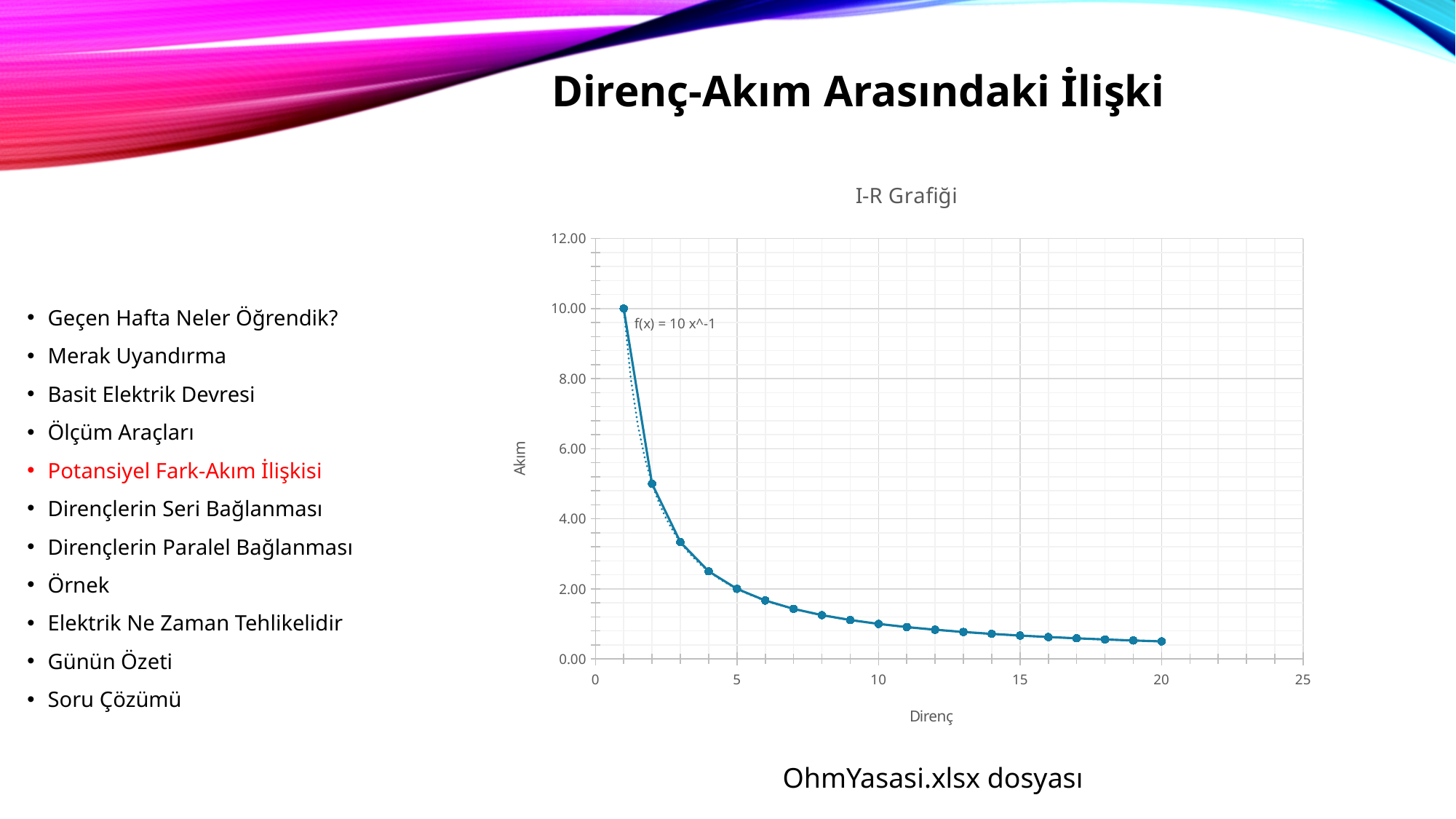
At which Direnç value is Akım lowest? 20 Is the Akım value at Direnç = 2 greater or less than 4.00? greater What kind of chart is shown on the slide? line chart What is the Akım value at Direnç = 1? 10.00 How many data points are plotted on the chart? 20 Which has the larger Akım value, Direnç = 3 or Direnç = 15? Direnç = 3 What is the title of the chart? I-R Grafiği What is the label of the x axis? Direnç Is the Akım value at Direnç = 10 greater or less than 2.00? less At which Direnç value is Akım highest? 1 What is the Akım value at Direnç = 5? 2.00 Do the Akım values rise or fall as Direnç increases? fall